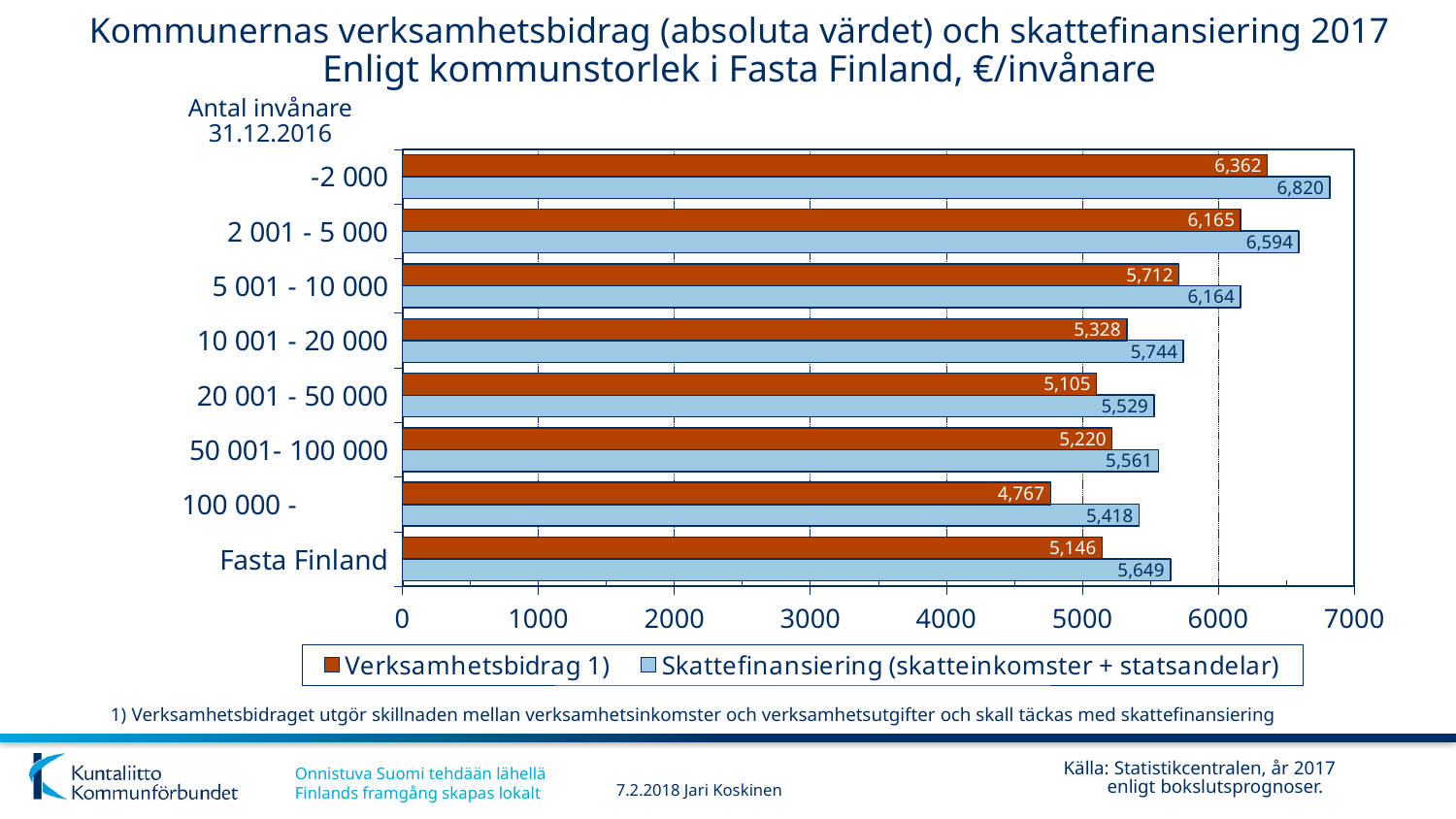
What is the difference between the Skattefinansiering and Verksamhetsbidrag values for the 100 000 - category? 651 Which series is shown in light blue in the legend? Skattefinansiering (skatteinkomster + statsandelar) Which is larger, the Verksamhetsbidrag value for 20 001 - 50 000 or for 50 001- 100 000? 50 001- 100 000 Which category has the lowest Verksamhetsbidrag value? 100 000 - Which category has the highest Skattefinansiering value? -2 000 How many series does the legend list? 2 How many categories are shown on the y axis? 8 What is the Verksamhetsbidrag value for the -2 000 category? 6,362 What is the Skattefinansiering value for the 10 001 - 20 000 category? 5,744 What is the Skattefinansiering value for Fasta Finland? 5,649 What is the total of the Verksamhetsbidrag and Skattefinansiering values for the 2 001 - 5 000 category? 12,759 What kind of chart is shown on the slide? Bar chart